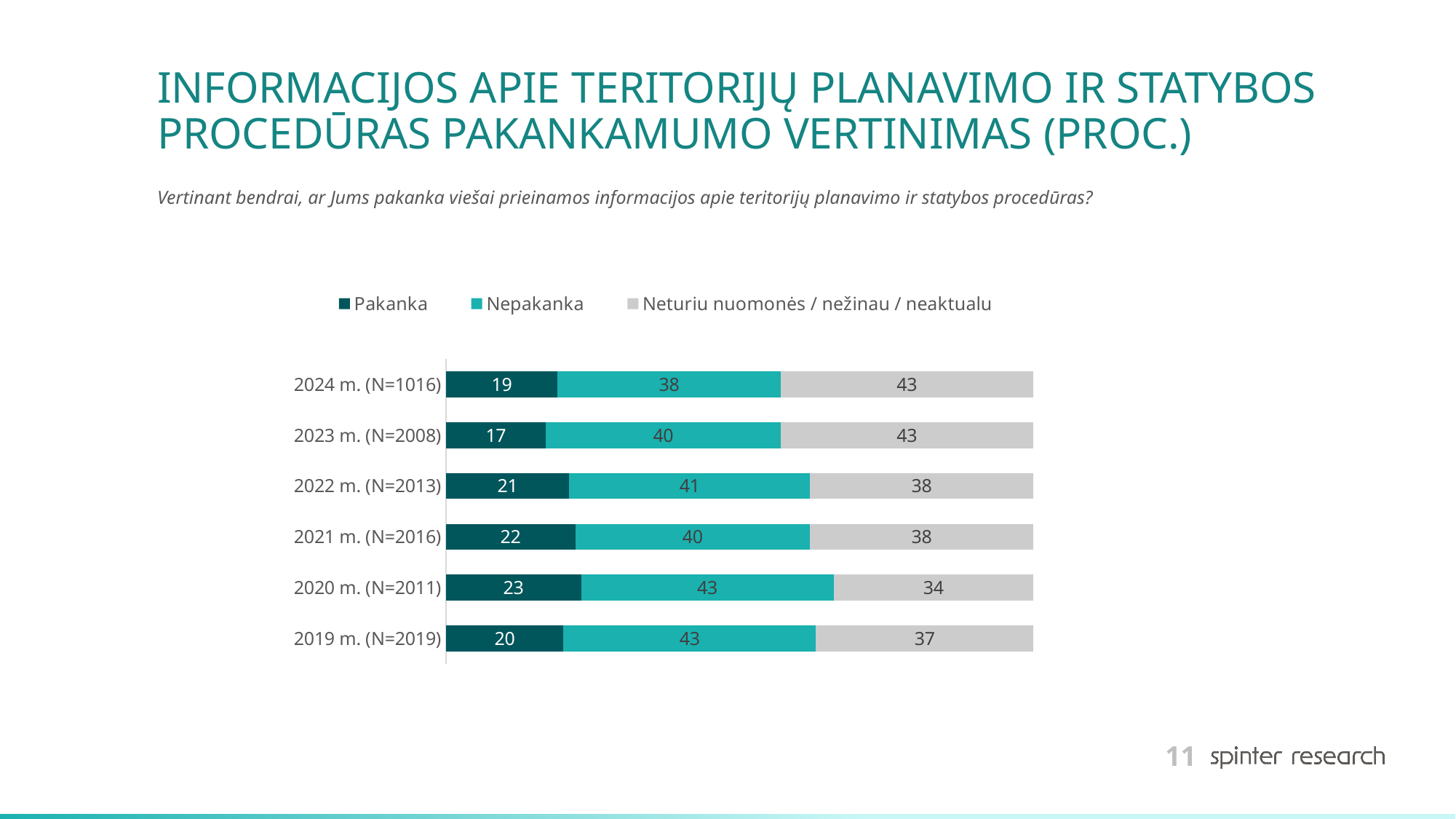
What is the value for Nepakanka in 2023 m. (N=2008)? 40 What is the value for Neturiu nuomonės / nežinau / neaktualu in 2020 m. (N=2011)? 34 What is the value for Pakanka in 2024 m. (N=1016)? 19 What is the total of the stacked bar for 2022 m. (N=2013)? 100 Which year has the highest value for Pakanka? 2020 m. (N=2011) What is the difference between the Nepakanka values for 2020 m. (N=2011) and 2024 m. (N=1016)? 5 How many series does the legend list? 3 Which year has the lowest value for Pakanka? 2023 m. (N=2008) Which is larger: the Neturiu nuomonės / nežinau / neaktualu value for 2024 m. (N=1016) or for 2019 m. (N=2019)? 2024 m. (N=1016) Which series is shown in grey in the chart? Neturiu nuomonės / nežinau / neaktualu What kind of chart is shown on the slide? Stacked bar chart How many years (categories) are shown in the chart? 6